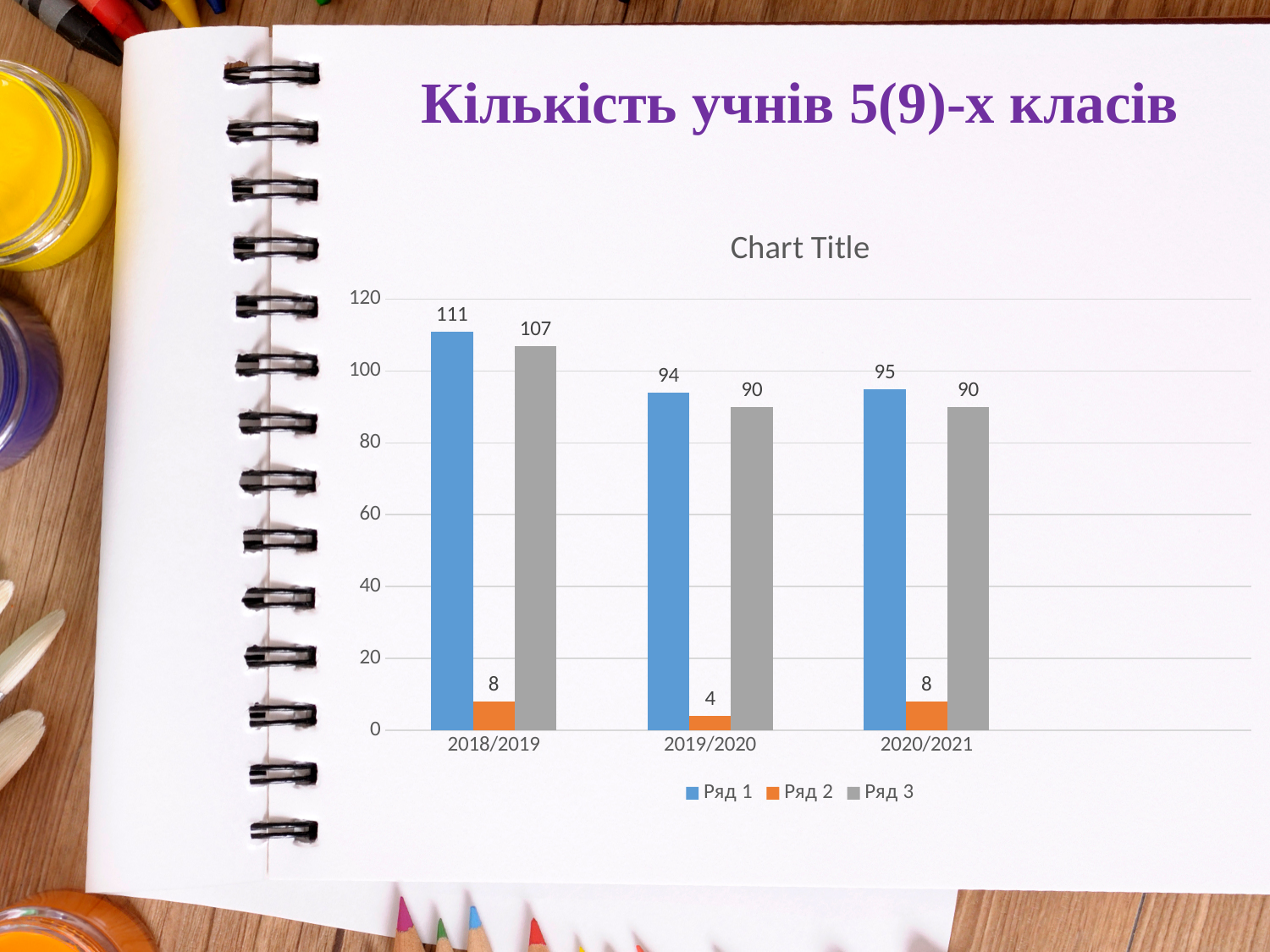
How many series does the legend list? 3 Which year has the highest value for Ряд 1? 2018/2019 What kind of chart is shown on the slide? Bar chart How many year categories are shown on the x axis? 3 Which is larger in 2020/2021: Ряд 1 or Ряд 3? Ряд 1 What is the value of Ряд 3 for 2019/2020? 90 What is the value of Ряд 1 for 2018/2019? 111 What is the title of the slide? Кількість учнів 5(9)-х класів Is the value of Ряд 3 for 2018/2019 greater or less than 100? greater What is the difference between Ряд 1 and Ряд 3 in 2018/2019? 4 What is the value of Ряд 2 for 2020/2021? 8 Which year has the lowest value for Ряд 2? 2019/2020